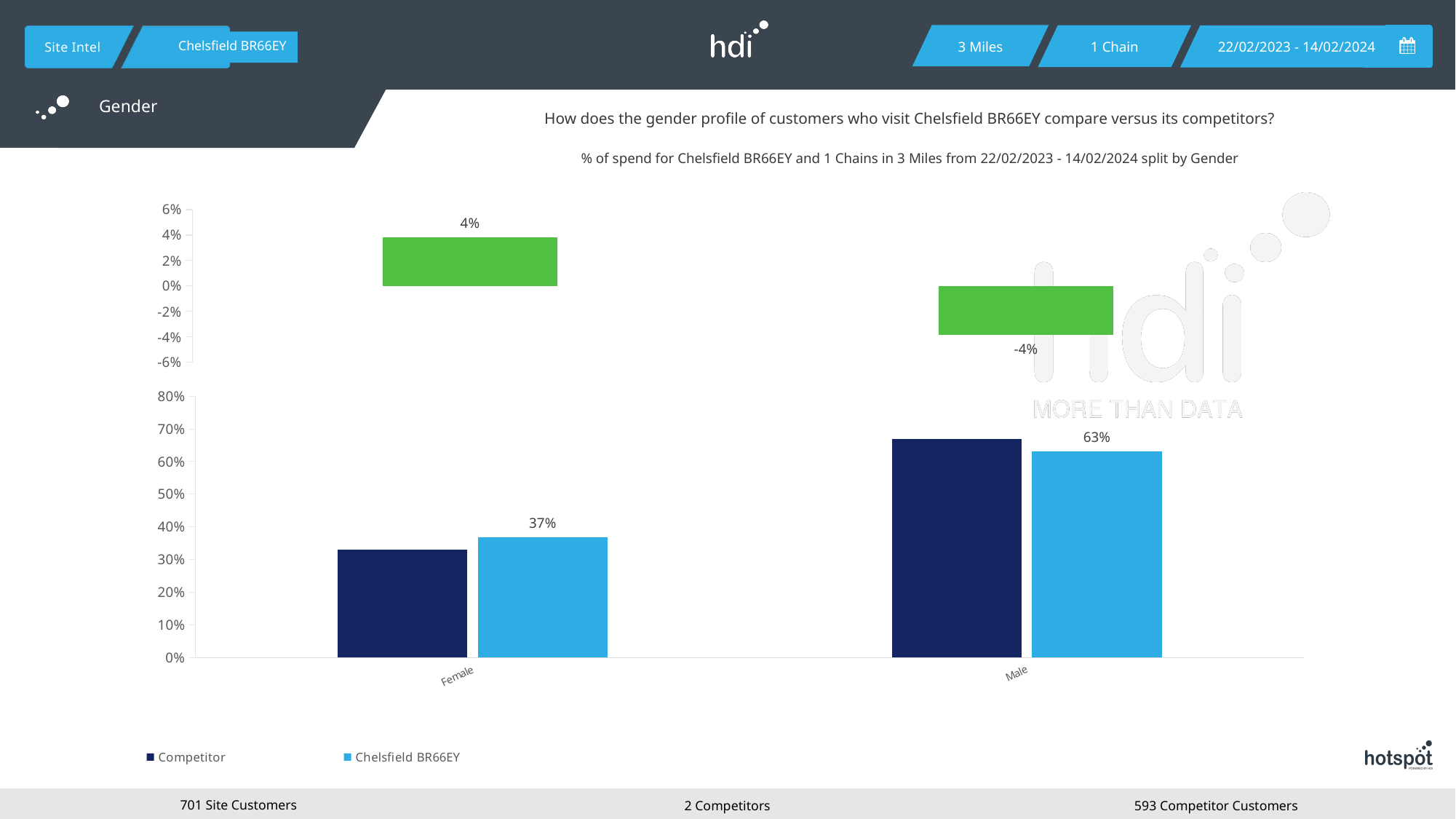
In the top chart, what is the value shown for Male? -4% In the bottom chart, what is the difference between the Chelsfield BR66EY values for Male and Female? 26% In the bottom chart, what is the value for Chelsfield BR66EY in the Female category? 37% What kind of chart is the bottom chart? bar chart In the top chart, what is the value shown for Female? 4% In the bottom chart, is the Competitor value for Female greater or less than 40%? less In the bottom chart, is the Competitor value for Male greater or less than 60%? greater In the bottom chart, which category has the higher value for Chelsfield BR66EY, Female or Male? Male How many series does the legend of the bottom chart list? 2 In the bottom chart, for the Female category, which is larger: the Competitor bar or the Chelsfield BR66EY bar? Chelsfield BR66EY In the bottom chart, for the Male category, which is larger: the Competitor bar or the Chelsfield BR66EY bar? Competitor In the bottom chart, what is the value for Chelsfield BR66EY in the Male category? 63%